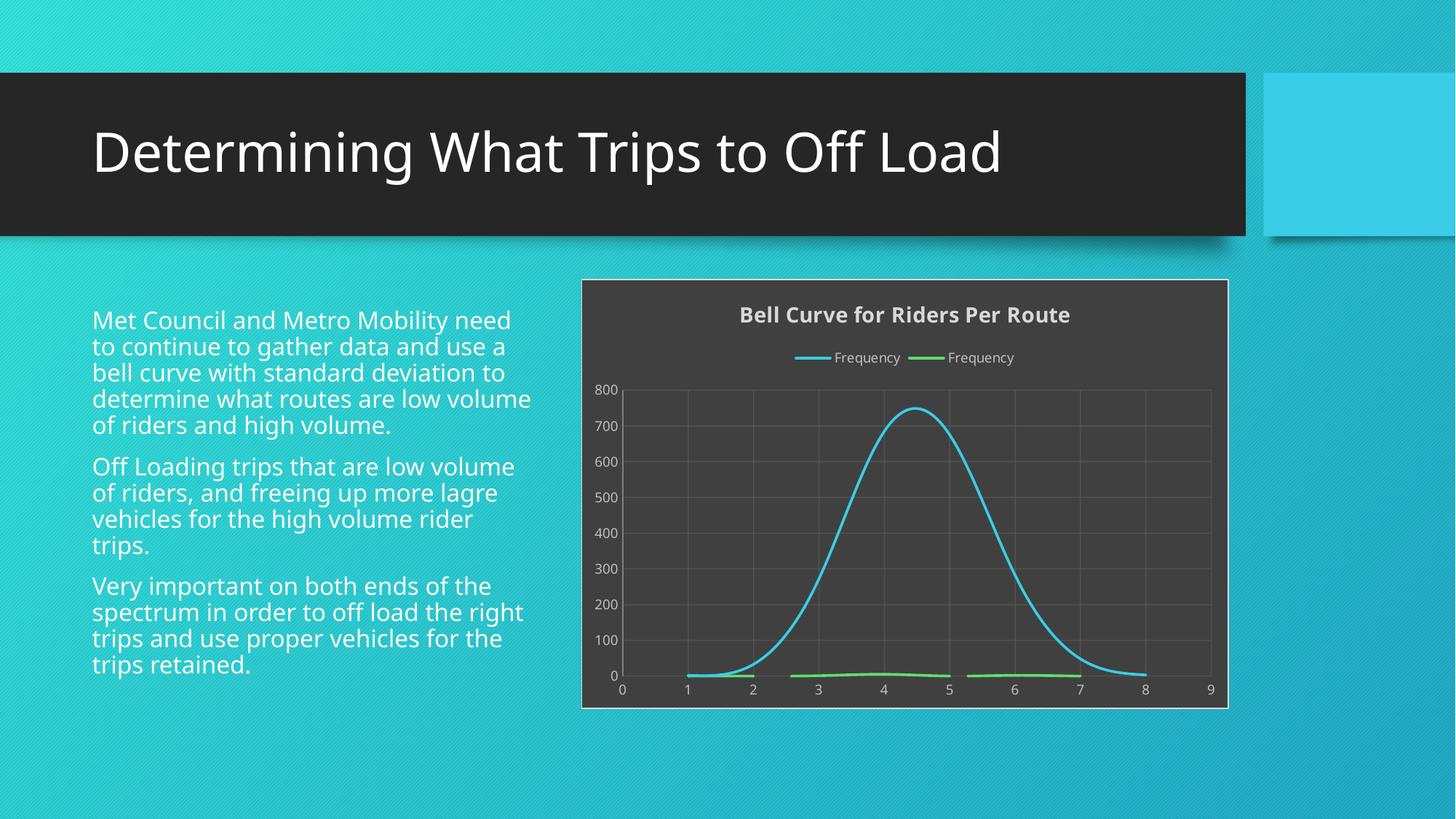
How many series does the chart's legend list? 2 Is the value of the blue Frequency curve at x = 2 greater or less than 100? less What is the highest value shown on the y axis? 800 Is the value of the blue Frequency curve at x = 7 greater or less than 100? less What kind of chart is shown on the slide? line chart What is the title of the chart? Bell Curve for Riders Per Route Does the blue Frequency curve rise or fall between x = 2 and x = 4? rise Which series stays near 0 across the chart, the blue one or the green one? the green one Is the peak value of the blue Frequency curve greater or less than 800? less Does the blue Frequency curve rise or fall between x = 5 and x = 7? fall What name is given to both series in the legend? Frequency